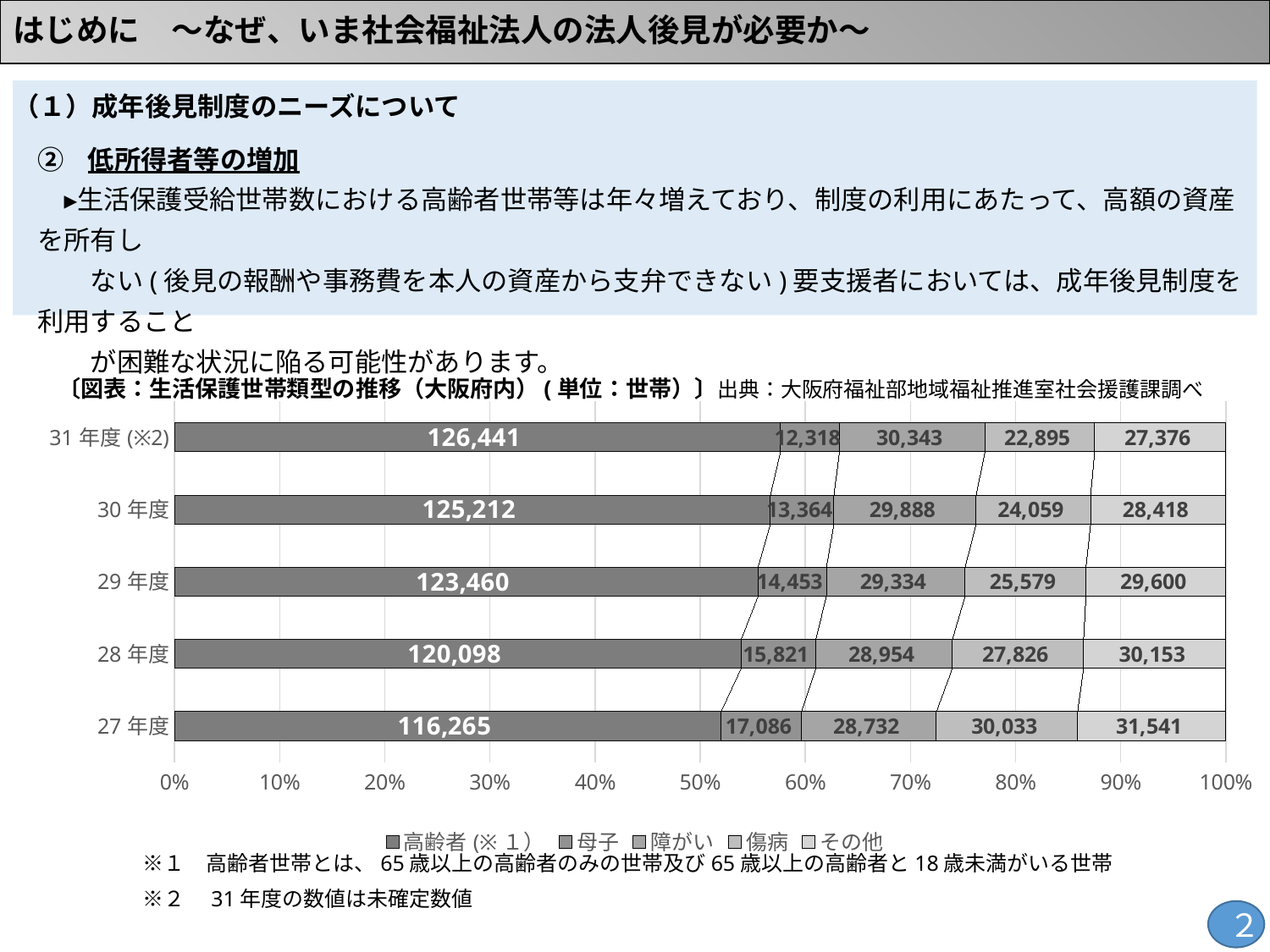
What kind of chart is shown? Stacked bar chart What is the total number of households for 27年度 across all series? 223,657 Which year has the highest value for 高齢者 (※１)? 31年度 (※2) How many series does the legend list? 5 What is the value for 傷病 in 29年度? 25,579 Which is larger: 障がい in 30年度 or 傷病 in 30年度? 障がい in 30年度 What is the value for 高齢者 (※１) in 31年度 (※2)? 126,441 How many years (categories) are shown in the chart? 5 What is the value for その他 in 28年度? 30,153 What is the difference between the 高齢者 (※１) values for 31年度 (※2) and 27年度? 10,176 What is the value for 母子 in 27年度? 17,086 Which year has the lowest value for 母子? 31年度 (※2)